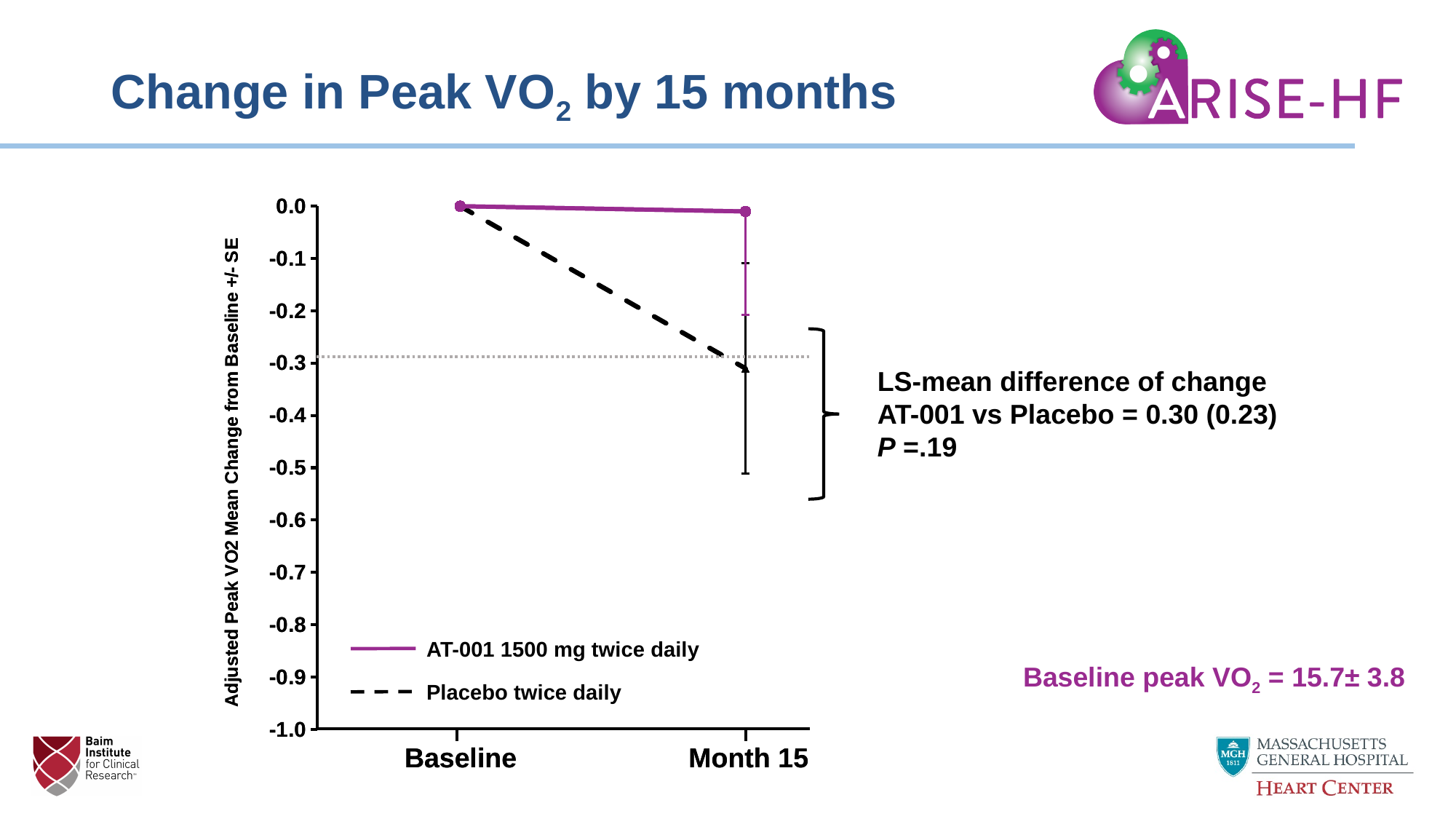
At Month 15, which series has the higher value, AT-001 1500 mg twice daily or Placebo twice daily? AT-001 1500 mg twice daily What P value is stated for the LS-mean difference of change? .19 Does the Placebo twice daily line rise or fall from Baseline to Month 15? fall How many time points are shown on the x axis? 2 Is the value for Placebo twice daily at Month 15 greater or less than -0.2? less Which series has the lowest value at Month 15? Placebo twice daily What kind of chart is shown on the slide? line chart What is the value for AT-001 1500 mg twice daily at Baseline? 0.0 What LS-mean difference of change for AT-001 vs Placebo is stated next to the chart? 0.30 (0.23) Is the value for AT-001 1500 mg twice daily at Month 15 greater or less than -0.1? greater What is the value for Placebo twice daily at Baseline? 0.0 How many series does the legend list? 2